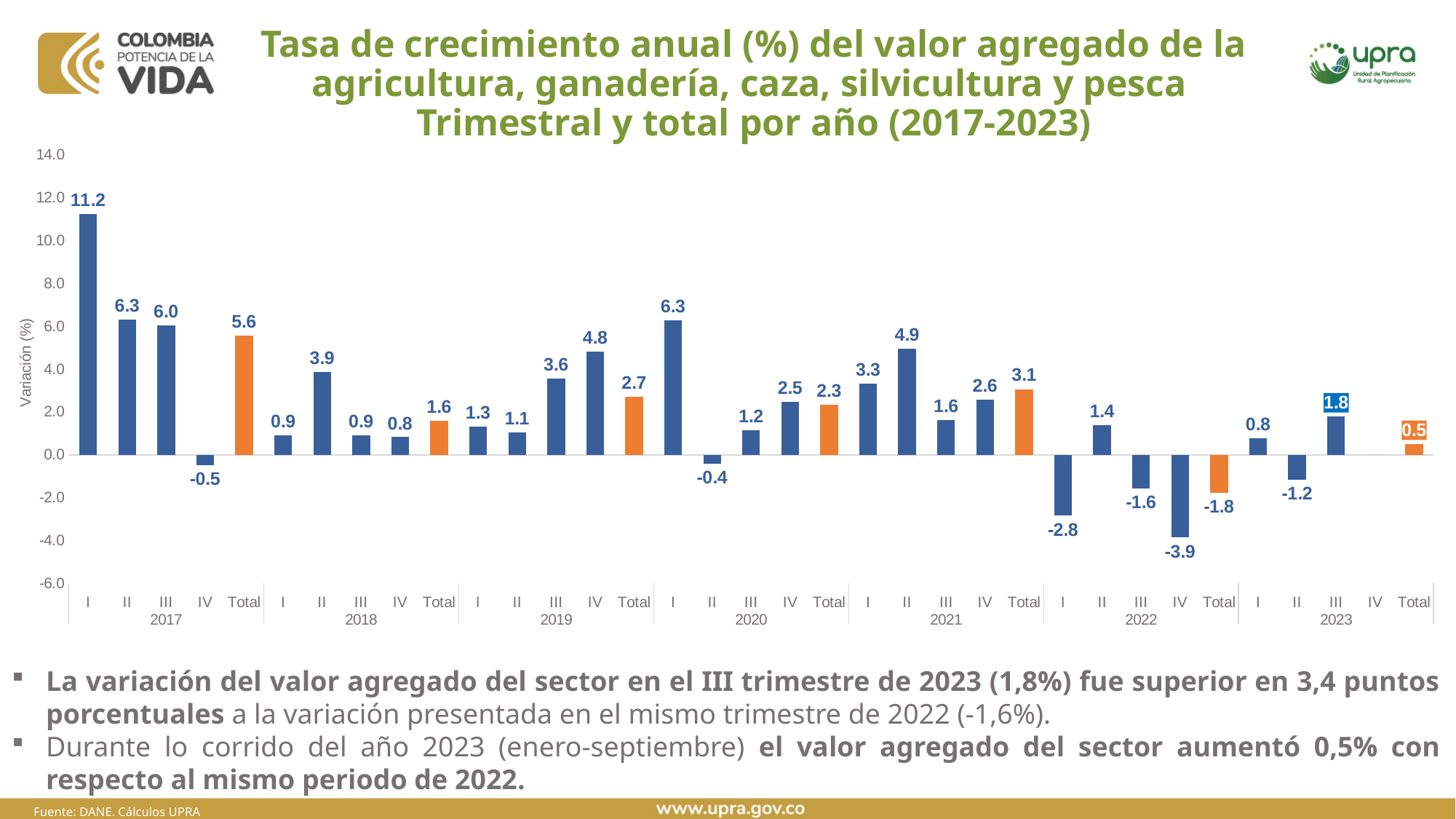
What type of chart is shown on the slide? bar chart Which quarter has the highest growth rate in the chart? I 2017 What is the annual total growth rate shown for 2017? 5.6 What is the difference between the value for quarter III of 2023 and quarter III of 2022? 3.4 Which quarter has the lowest growth rate in the chart? IV 2022 What is the value for quarter IV of 2022? -3.9 What is the annual total value shown for 2023? 0.5 How many annual 'Total' bars are shown in the chart? 7 What colour are the annual 'Total' bars in the chart? orange What is the label of the vertical axis? Variación (%) What is the value for quarter III of 2023? 1.8 Which is larger, the annual total for 2019 or the annual total for 2021? 2021